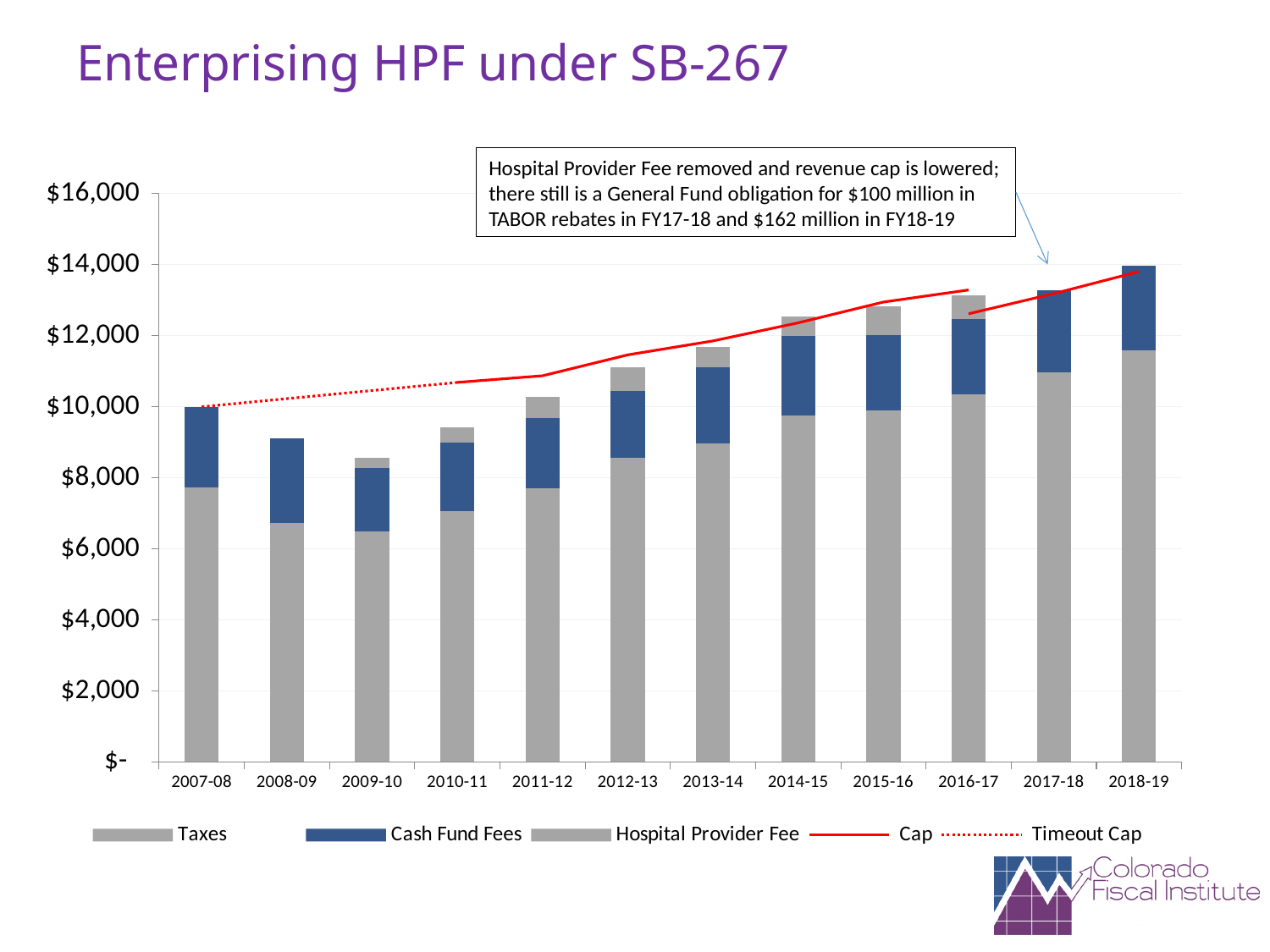
Which fiscal year has the lowest total bar? 2009-10 How many series does the legend list? 5 Is the total bar for 2009-10 greater or less than $8,000? greater What kind of chart is shown on the slide? Stacked bar chart with line series Is the total bar for 2016-17 greater or less than $12,000? greater Is the total bar for 2008-09 greater or less than $10,000? less Do the total bars generally rise or fall from 2009-10 to 2018-19? rise Which fiscal year has the highest total bar? 2018-19 What is the title of the slide? Enterprising HPF under SB-267 How many fiscal years are shown on the x axis? 12 Which fiscal year has a larger total bar, 2013-14 or 2014-15? 2014-15